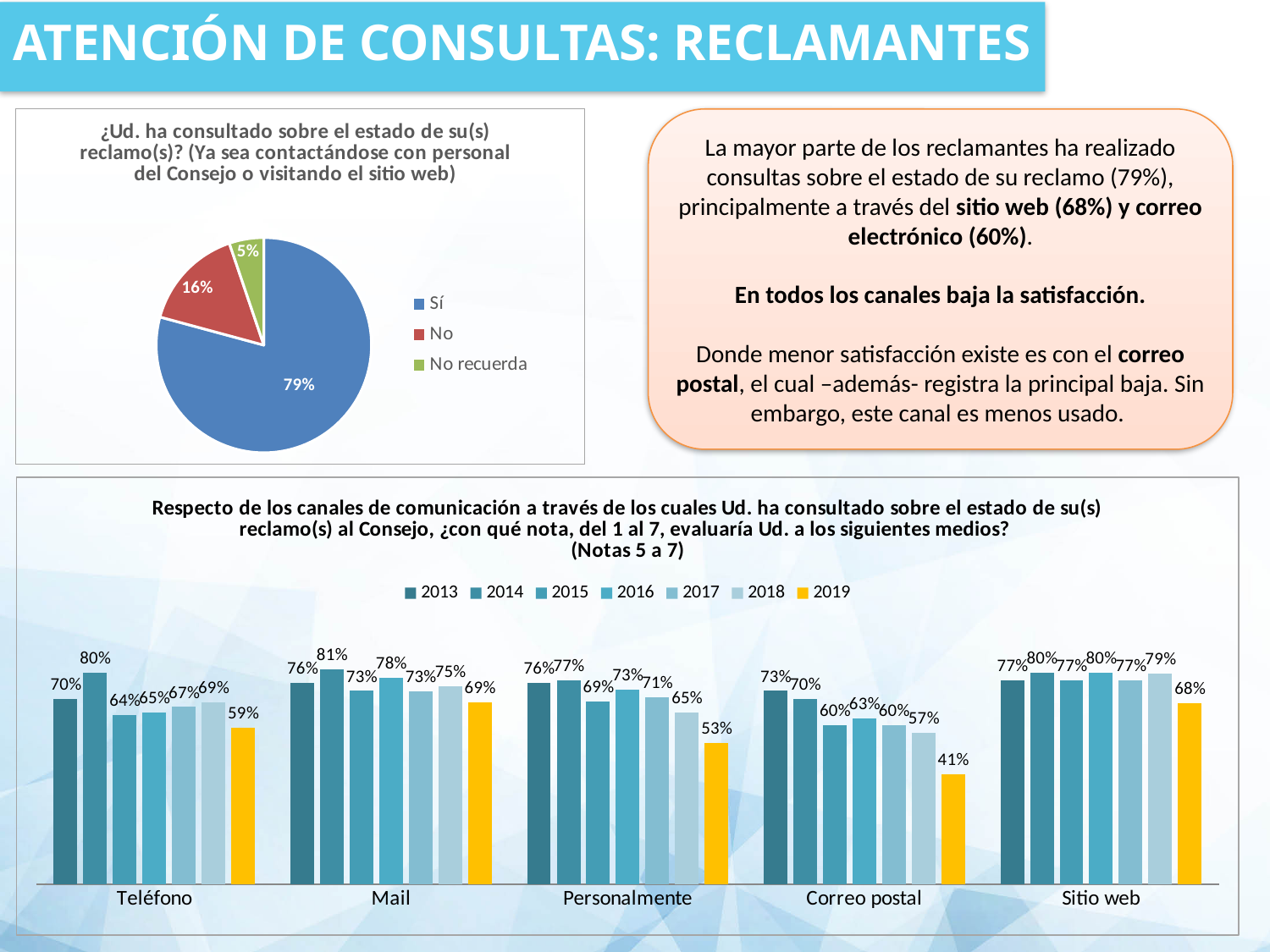
In the bottom bar chart, how many channel categories are shown on the x axis? 5 What type of chart is the bottom chart? Bar chart In the pie chart on the top left, how many categories does the legend list? 3 In the bottom bar chart, which channel has the lowest 2019 value? Correo postal In the pie chart on the top left, what share does the "No recuerda" slice represent? 5% In the bottom bar chart, what is the 2014 value for Teléfono? 80% In the bottom bar chart, what is the difference between the 2018 and 2019 values for Personalmente? 12% In the pie chart on the top left, which category has the smallest slice? No recuerda In the bottom bar chart, which is larger for Mail: the 2014 value or the 2019 value? 2014 In the bottom bar chart, how many series does the legend list? 7 In the pie chart on the top left, what percentage of respondents answered "Sí"? 79% In the bottom bar chart, what is the 2019 value for Correo postal? 41%